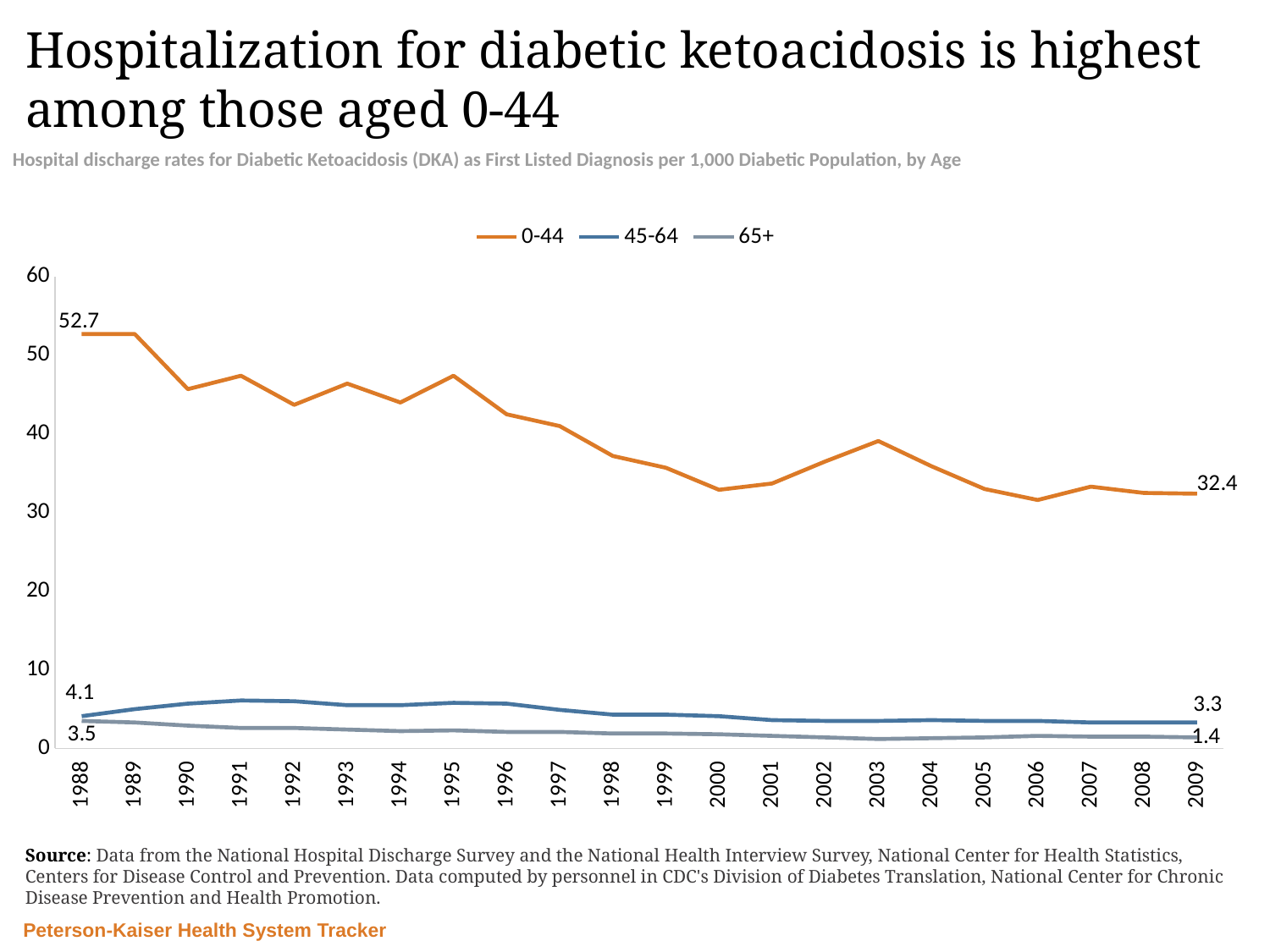
What is the value for the 0-44 age group in 1988? 52.7 What is the value for the 0-44 age group in 2009? 32.4 What is the value for the 65+ age group in 2009? 1.4 Which age group has the lowest hospital discharge rate in 1988? 65+ Is the value for the 0-44 age group in 2003 greater or less than 40? less What is the value for the 45-64 age group in 1988? 4.1 What is the difference between the 45-64 and 65+ values in 2009? 1.9 How many series does the legend list? 3 Does the value for the 0-44 age group generally rise or fall from 1988 to 2009? fall By how much did the value for the 0-44 age group fall from 1988 to 2009? 20.3 What kind of chart is shown on the slide? line chart Which age group has the highest hospital discharge rate in 2009? 0-44